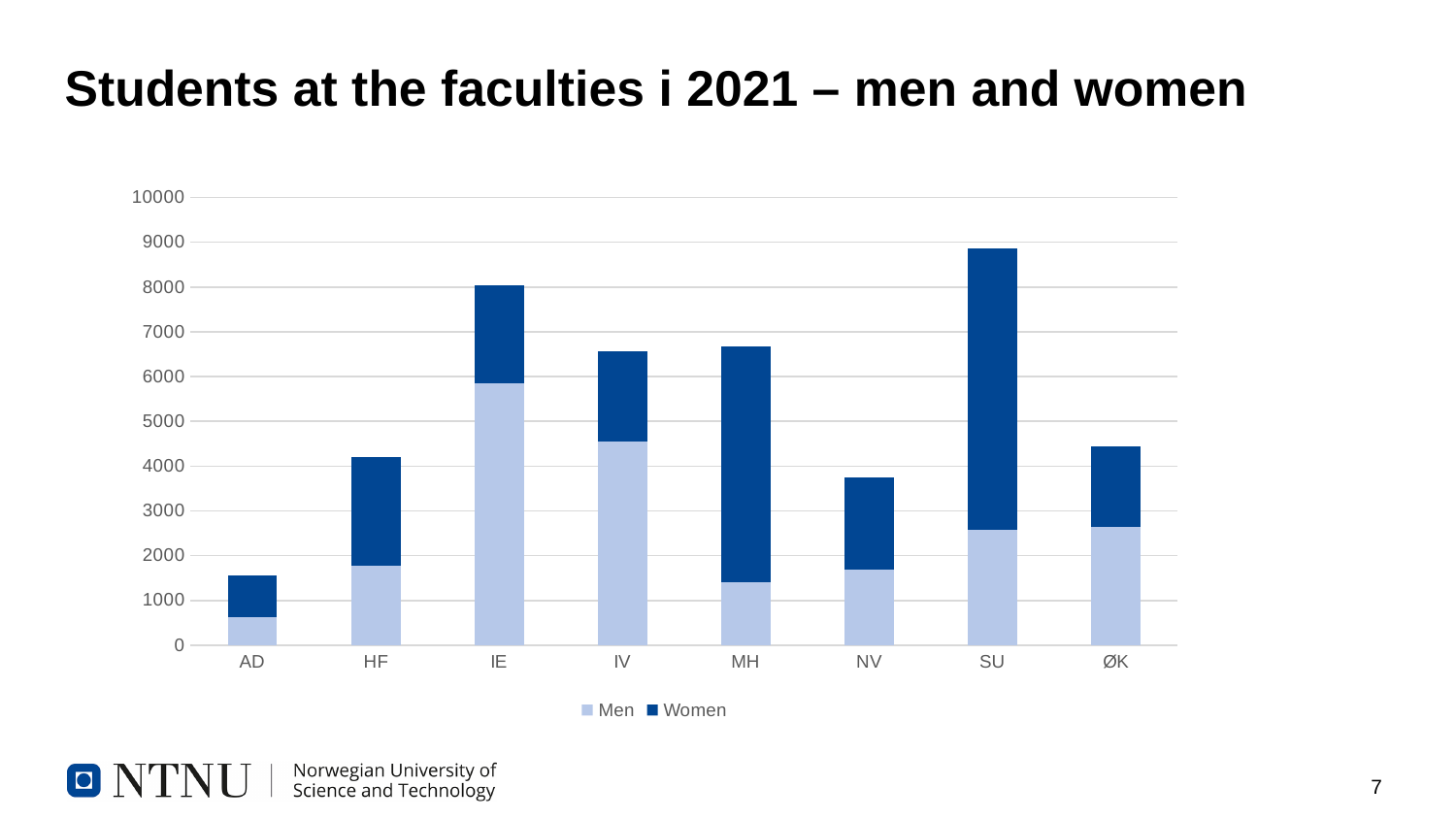
Which faculty has the lowest total number of students? AD How many series does the legend list? 2 Is the total number of students at AD greater or less than 2000? less Which series is shown in the darker blue colour? Women How many faculties are shown on the x axis of the chart? 8 Is the number of men at IE greater or less than 5000? greater Which faculty has more students in total, IE or SU? SU Which faculty has the highest number of men? IE Which faculty has the highest number of women? SU What kind of chart is shown on the slide? Stacked bar chart Is the total number of students at SU greater or less than 8000? greater Which faculty has the highest total number of students? SU